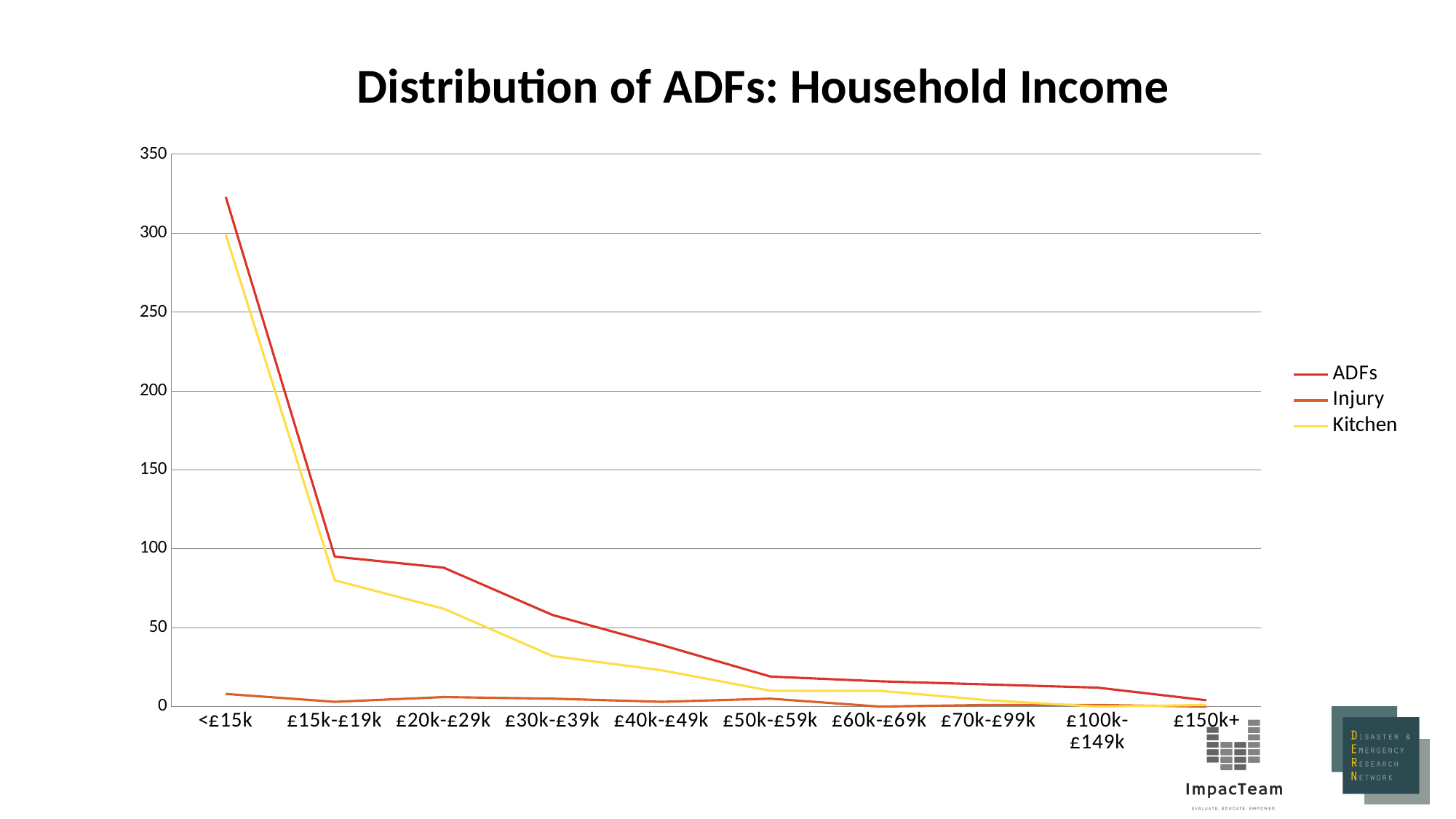
Which household income category has the highest value for Kitchen? <£15k Do the ADFs values generally rise or fall as household income increases along the x axis? fall Is the value for ADFs at £15k-£19k greater or less than 100? less Which household income category has the highest value for ADFs? <£15k Is the value for ADFs at <£15k greater or less than 300? greater At £30k-£39k, which series has the larger value, ADFs or Kitchen? ADFs What is the title of the chart? Distribution of ADFs: Household Income What kind of chart is shown on the slide? line chart How many household income categories are shown on the x axis? 10 How many series does the legend list? 3 Is the value for Kitchen at <£15k greater or less than 250? greater